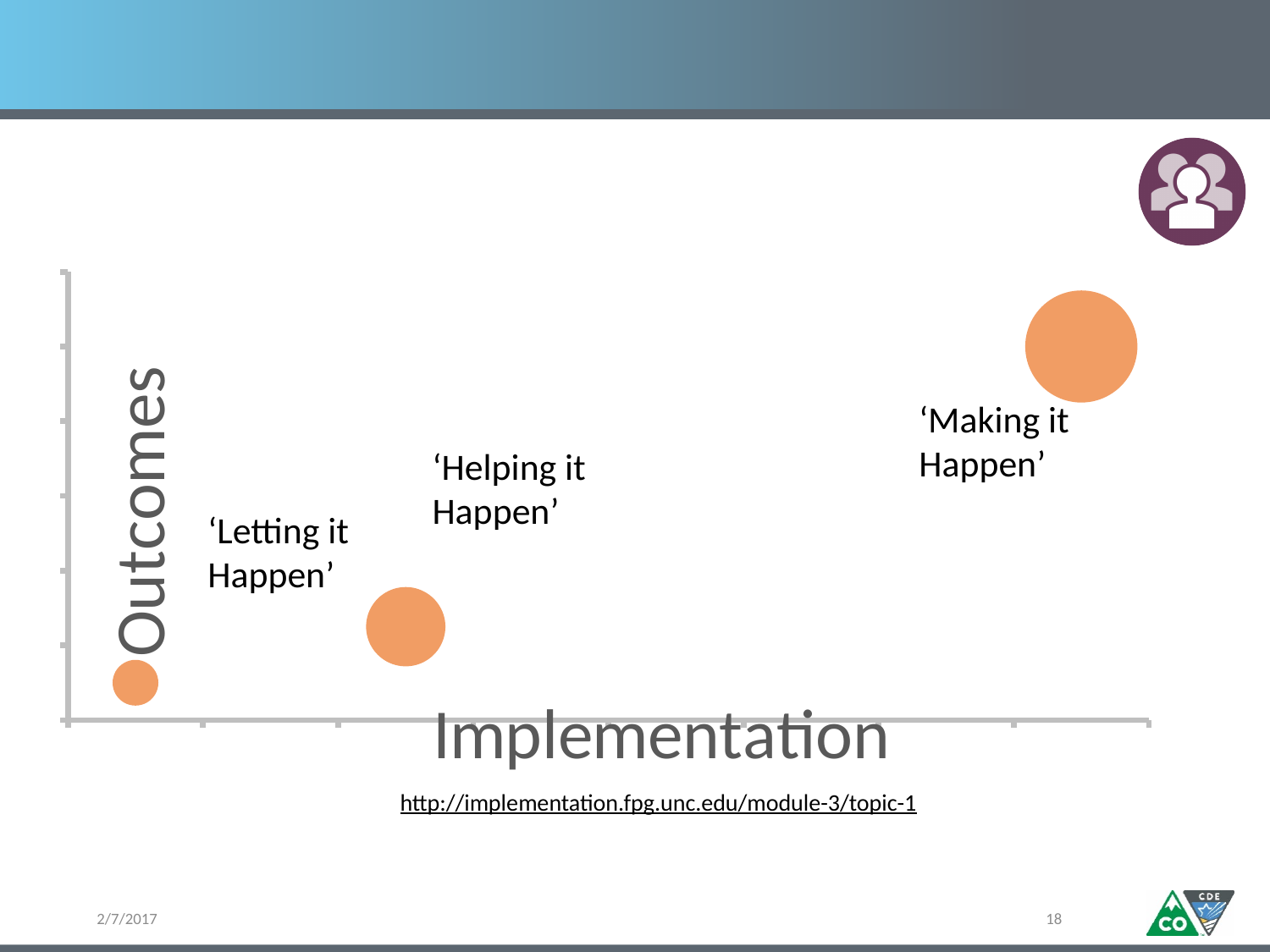
What kind of chart is shown on the slide? Bubble chart How many data points (bubbles) are plotted on the chart? 3 What is the title of the vertical axis? Outcomes Do the Outcomes values rise or fall as Implementation increases along the x axis? Rise Which point is plotted furthest to the left along the Implementation axis? 'Letting it Happen' Which point has the lowest Outcomes value? 'Letting it Happen' Which has the higher Outcomes value, 'Making it Happen' or 'Helping it Happen'? 'Making it Happen' Which has the higher Outcomes value, 'Helping it Happen' or 'Letting it Happen'? 'Helping it Happen' What is the title of the horizontal axis? Implementation Which point is plotted furthest to the right along the Implementation axis? 'Making it Happen' Which point has the highest Outcomes value? 'Making it Happen' Which bubble is the largest in size? 'Making it Happen'